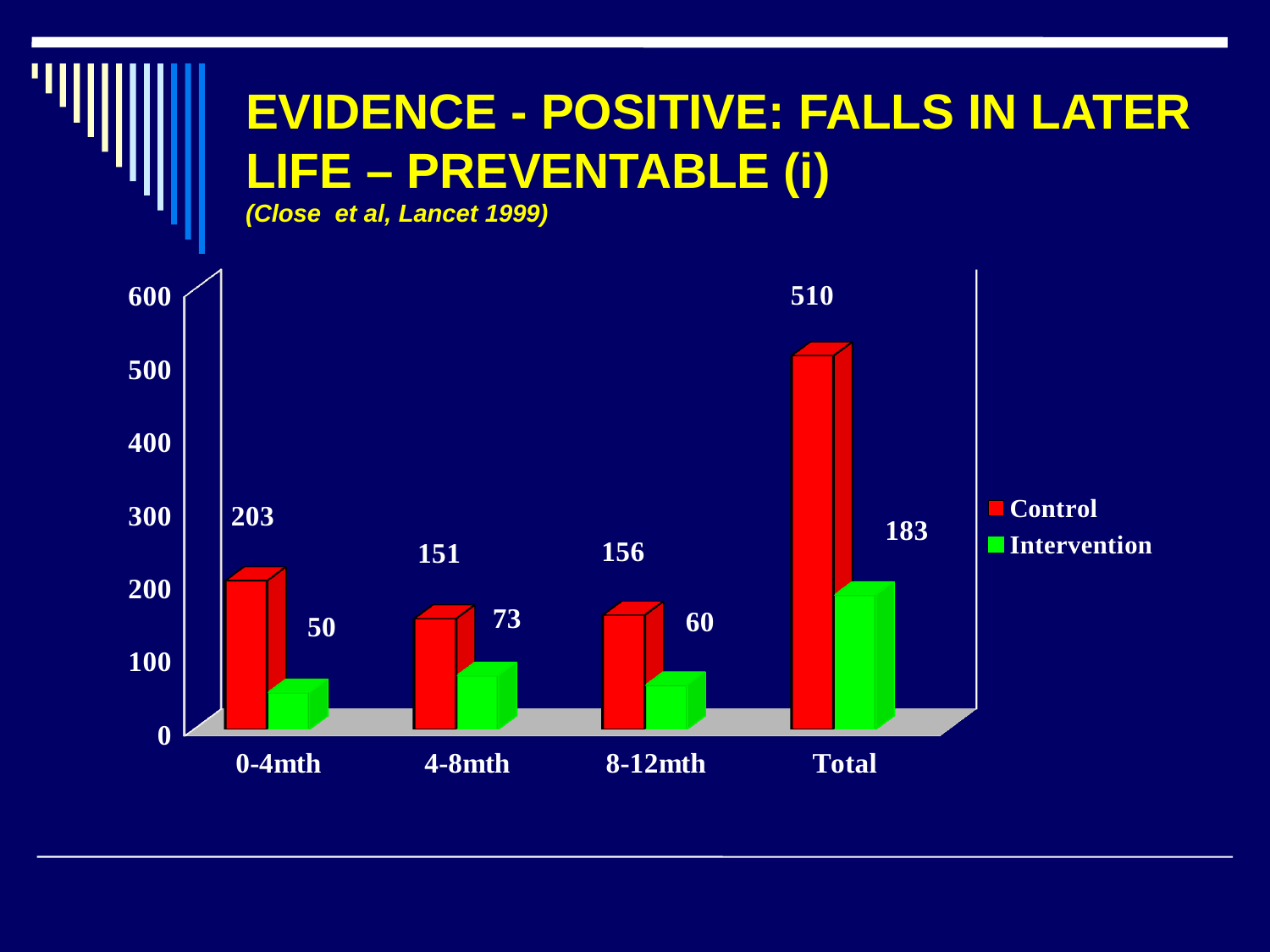
What is the Control value for 0-4mth? 203 What kind of chart is shown on the slide? Bar chart What is the difference between the Control and Intervention values for Total? 327 What is the Intervention value for 8-12mth? 60 How many categories are shown on the x axis? 4 What is the Control value for Total? 510 Which category has the lowest Intervention value? 0-4mth What is the difference between the Control values for 8-12mth and 4-8mth? 5 Among the three time periods (excluding Total), which has the highest Control value? 0-4mth Which is larger, the Intervention value for 4-8mth or the Intervention value for 8-12mth? 4-8mth What is the Intervention value for 4-8mth? 73 How many series does the legend list? 2